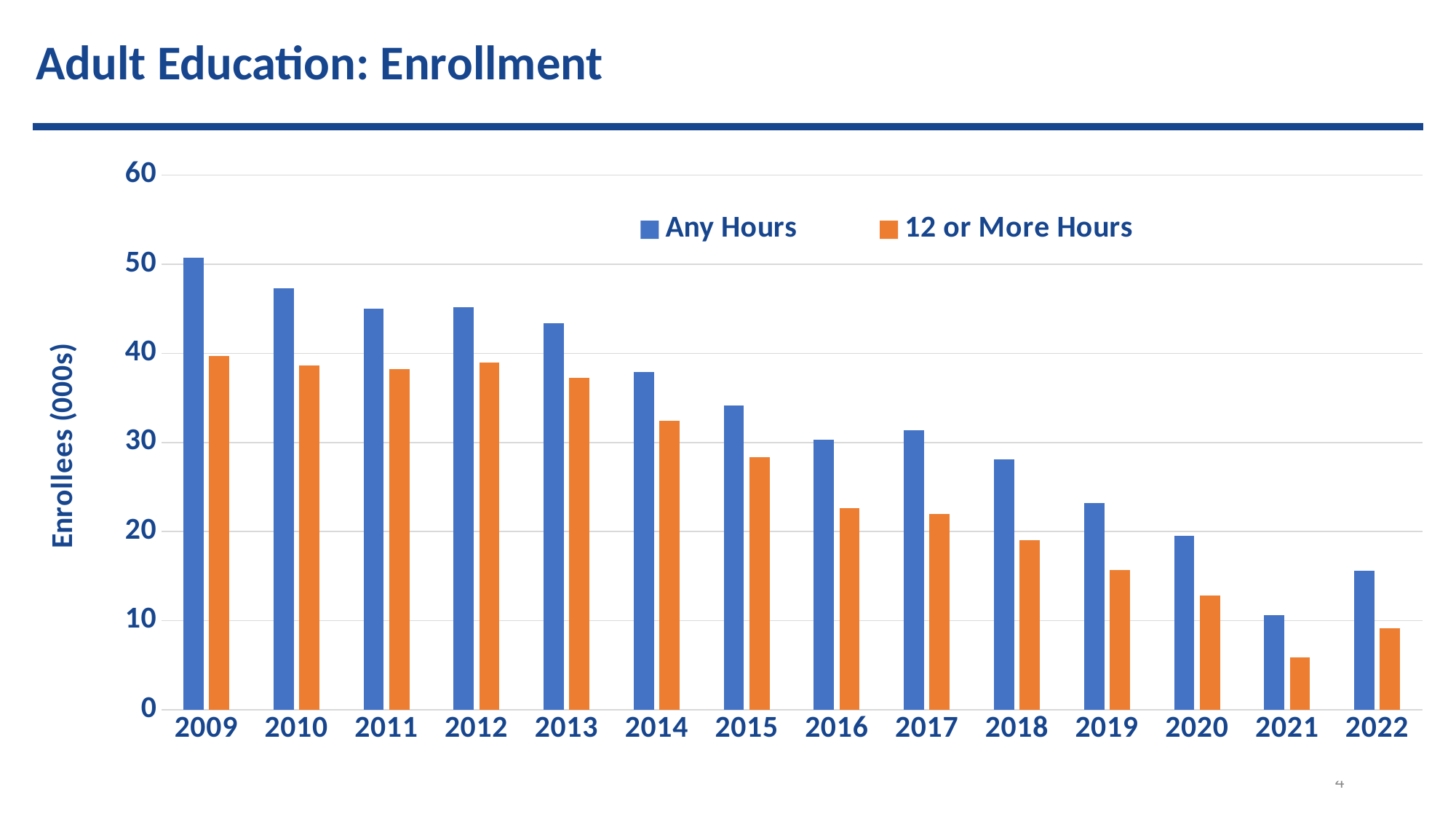
Is the value for Any Hours in 2014 greater or less than 40? less Is the value for 12 or More Hours in 2021 greater or less than 10? less Which year has the highest value for Any Hours? 2009 Which year has the lowest value for Any Hours? 2021 How many years are shown on the x axis? 14 Is the value for Any Hours in 2019 greater or less than 20? greater What kind of chart is shown on the slide? bar chart What is the label on the y axis? Enrollees (000s) How many series does the legend list? 2 Do the Any Hours values generally rise or fall from 2009 to 2022? fall Which year has the lowest value for 12 or More Hours? 2021 Which is larger, the Any Hours value for 2021 or for 2022? 2022